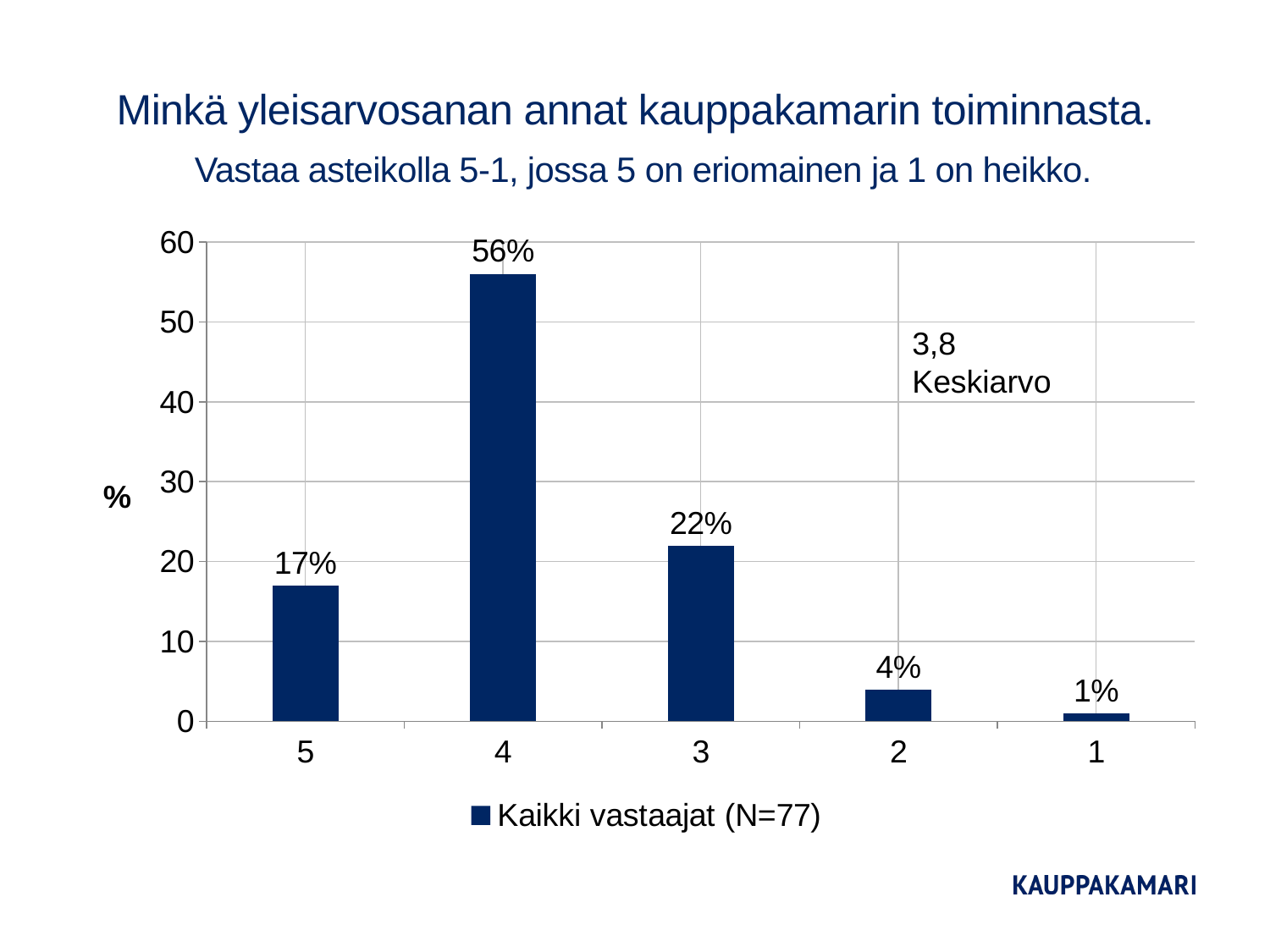
What percentage of respondents gave a rating of 4? 56% What percentage of respondents gave a rating of 1? 1% How many rating categories are shown on the x axis? 5 What average (Keskiarvo) is annotated on the chart? 3,8 What is the difference in percentage points between the share for rating 4 and the share for rating 3? 34 How many series does the legend list? 1 Is the value for rating 3 greater or less than 20? greater Which rating received the highest share of respondents? 4 What kind of chart is shown on the slide? bar chart Which rating received the lowest share of respondents? 1 What percentage of respondents gave a rating of 5? 17% Which is larger, the share for rating 5 or the share for rating 3? rating 3